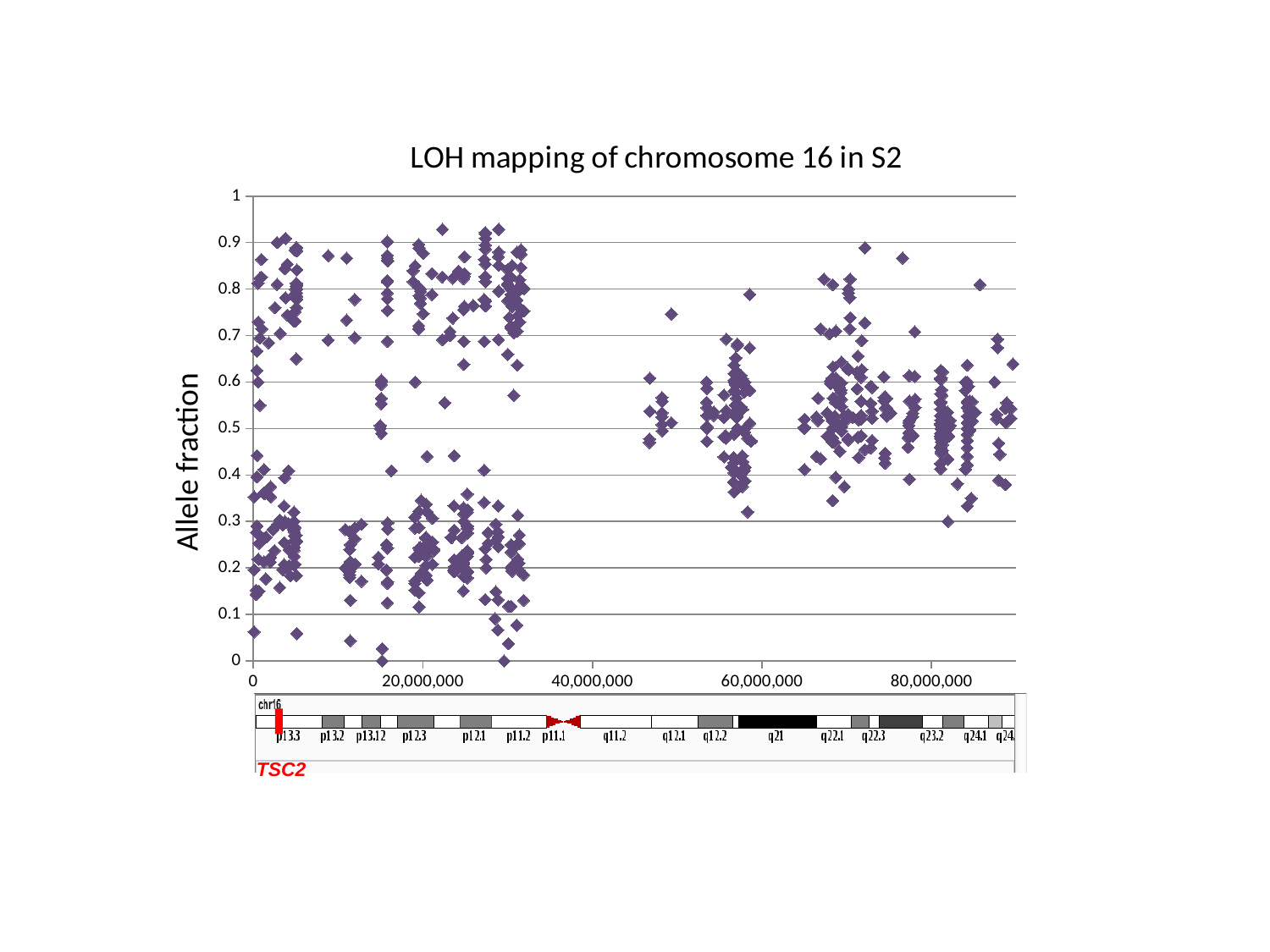
Is the highest allele fraction plotted on the chart greater or less than 0.9? greater What kind of chart is shown on the slide? Scatter plot How many labelled tick marks are on the horizontal axis of the chart? 5 Is the lowest allele fraction plotted on the chart greater or less than 0.1? less What is the largest value labelled on the vertical axis of the chart? 1 How many labelled tick marks are on the vertical axis of the chart? 11 What is the label on the vertical axis of the chart? Allele fraction What is the title of the chart? LOH mapping of chromosome 16 in S2 What is the largest value labelled on the horizontal axis of the chart? 80,000,000